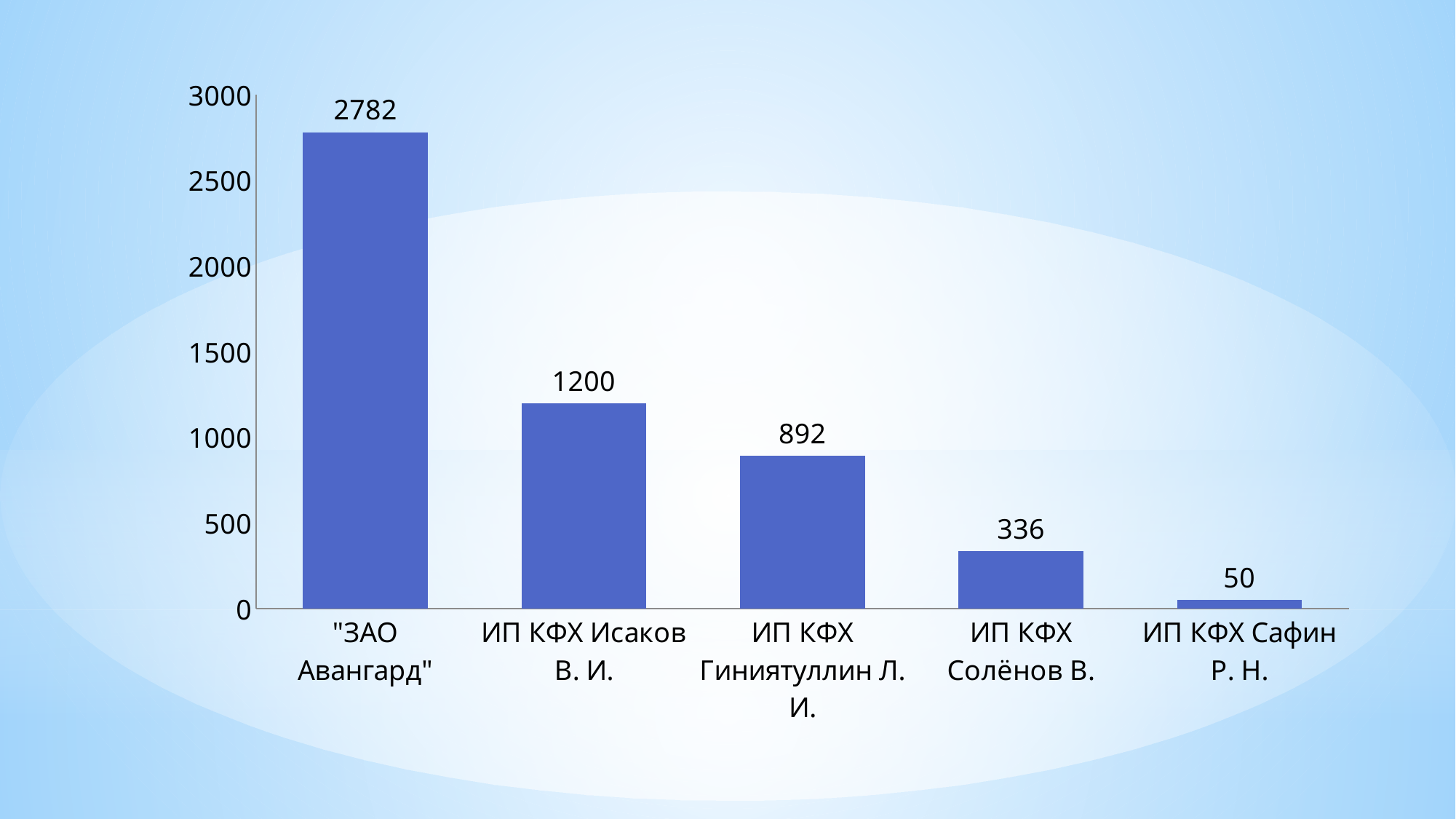
What is the value for ИП КФХ Гиниятуллин Л. И.? 892 What kind of chart is shown on the slide? bar chart What is the value for ИП КФХ Сафин Р. Н.? 50 What is the difference between the values for "ЗАО Авангард" and ИП КФХ Исаков В. И.? 1582 Is the value for ИП КФХ Солёнов В. greater or less than 500? less Which category has the highest value? "ЗАО Авангард" Which category has the lowest value? ИП КФХ Сафин Р. Н. What is the value for ИП КФХ Исаков В. И.? 1200 Which is larger, the value for ИП КФХ Гиниятуллин Л. И. or the value for ИП КФХ Солёнов В.? ИП КФХ Гиниятуллин Л. И. What is the value for "ЗАО Авангард"? 2782 What is the value for ИП КФХ Солёнов В.? 336 How many categories are shown in the chart? 5